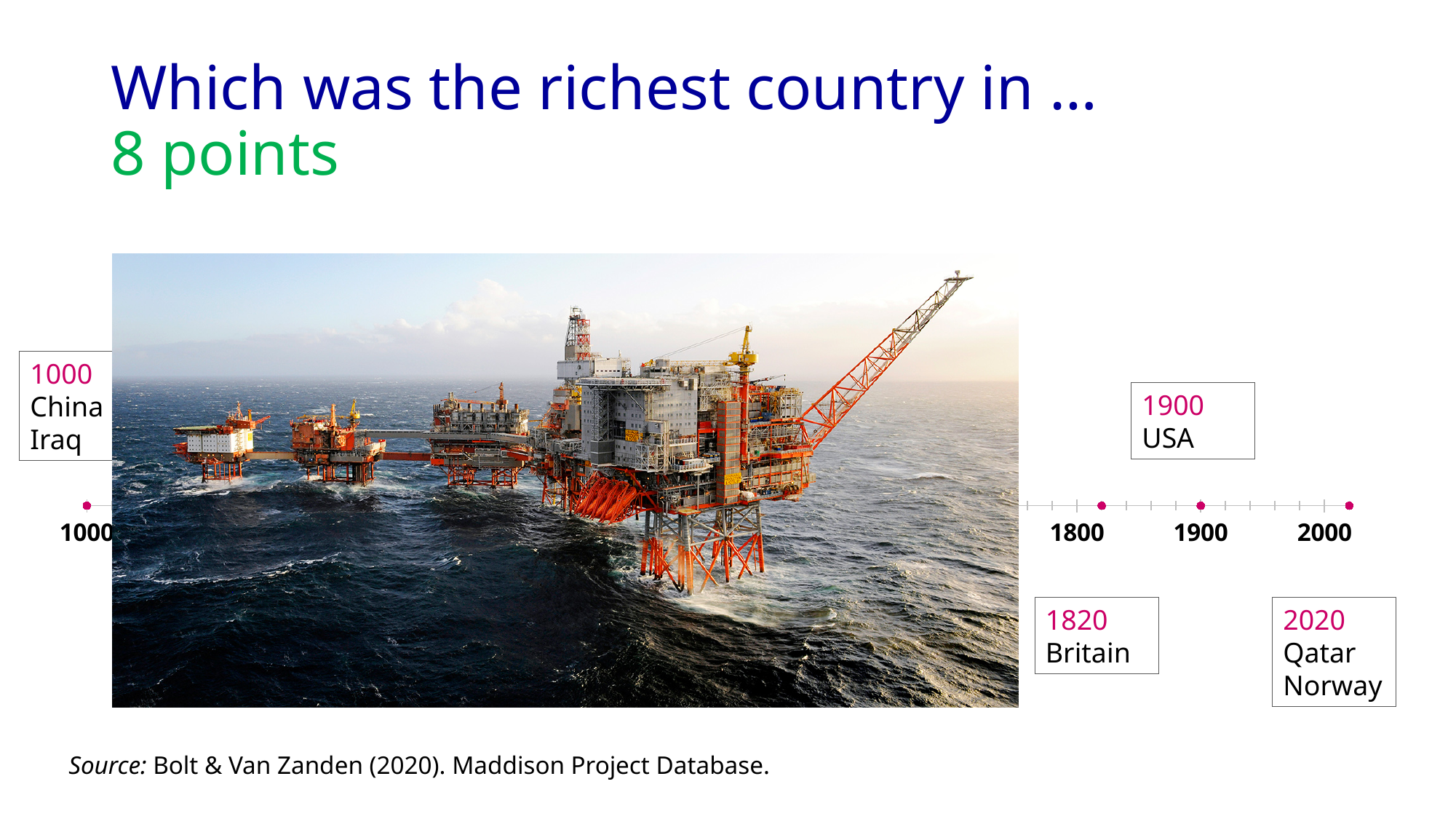
Which is the later point on the timeline, the one labelled USA or the one labelled Britain? USA What is the latest year marked on the timeline? 2020 What is the earliest year marked on the timeline? 1000 According to the timeline, which country was the richest in 1900? USA In which year is Britain labelled as the richest country on the timeline? 1820 According to the timeline, which country was the richest in 1820? Britain How many years apart are the points labelled Britain and USA on the timeline? 80 Which two countries are labelled as the richest in 2020 on the timeline? Qatar and Norway What is the source cited for the timeline data? Bolt & Van Zanden (2020). Maddison Project Database. In which year is the USA labelled as the richest country on the timeline? 1900 Which two countries are labelled as the richest in the year 1000 on the timeline? China and Iraq How many labelled points (years) are marked on the timeline? 4